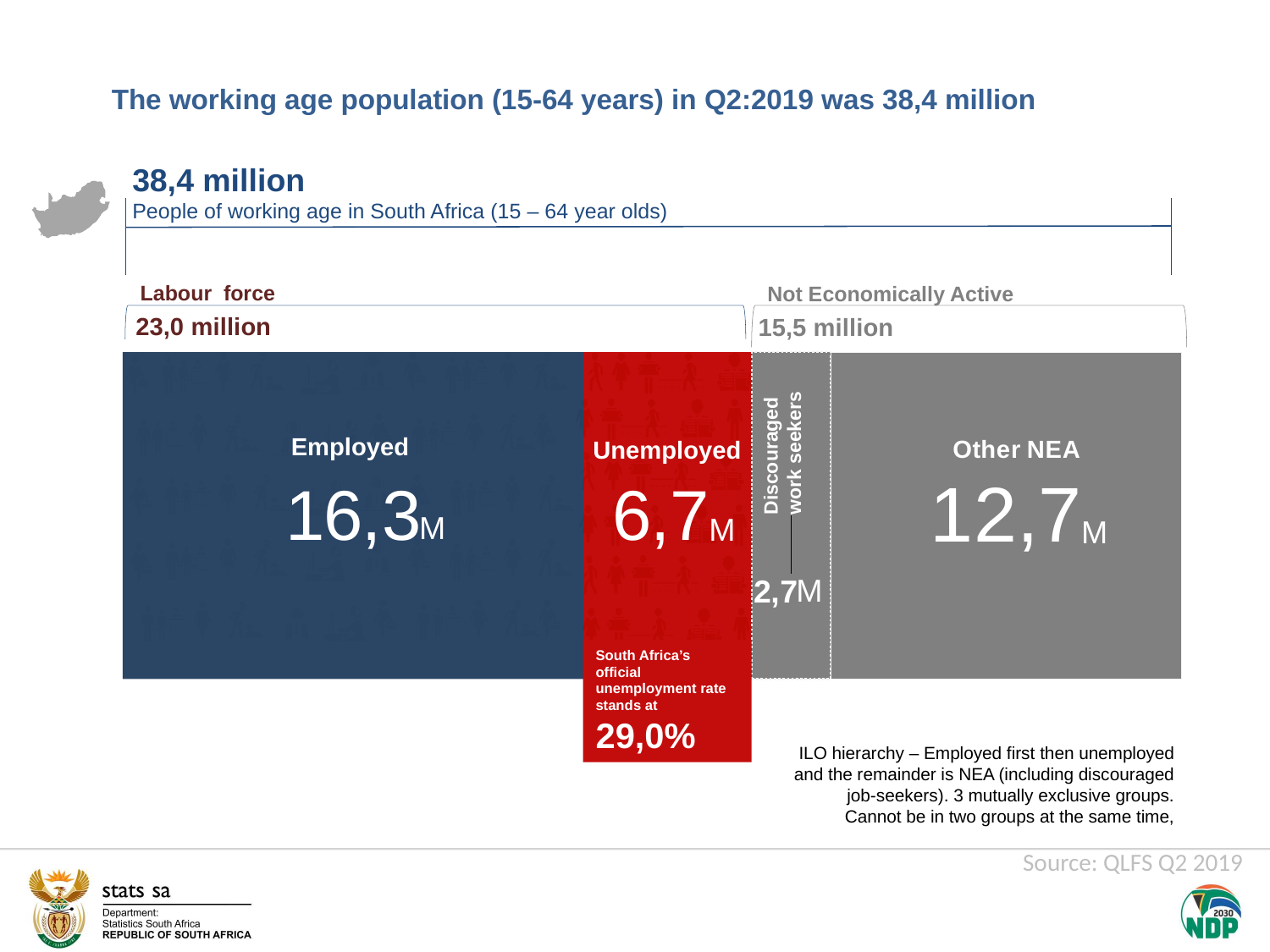
Which of the four groups in the diagram is the largest? Employed What value is shown for discouraged work seekers? 2,7M What is the number of unemployed people shown in the diagram? 6,7M What is the number of employed people shown in the diagram? 16,3M Which of the four groups in the diagram is the smallest? Discouraged work seekers What value is shown for Other NEA? 12,7M What is South Africa's official unemployment rate shown on the slide? 29,0% What is the difference between the Employed and Unemployed values? 9,6M What is the size of the labour force shown on the slide? 23,0 million What colour is the Employed block in the diagram? Blue What is the size of the Not Economically Active population shown on the slide? 15,5 million Which is larger, Other NEA or Unemployed? Other NEA